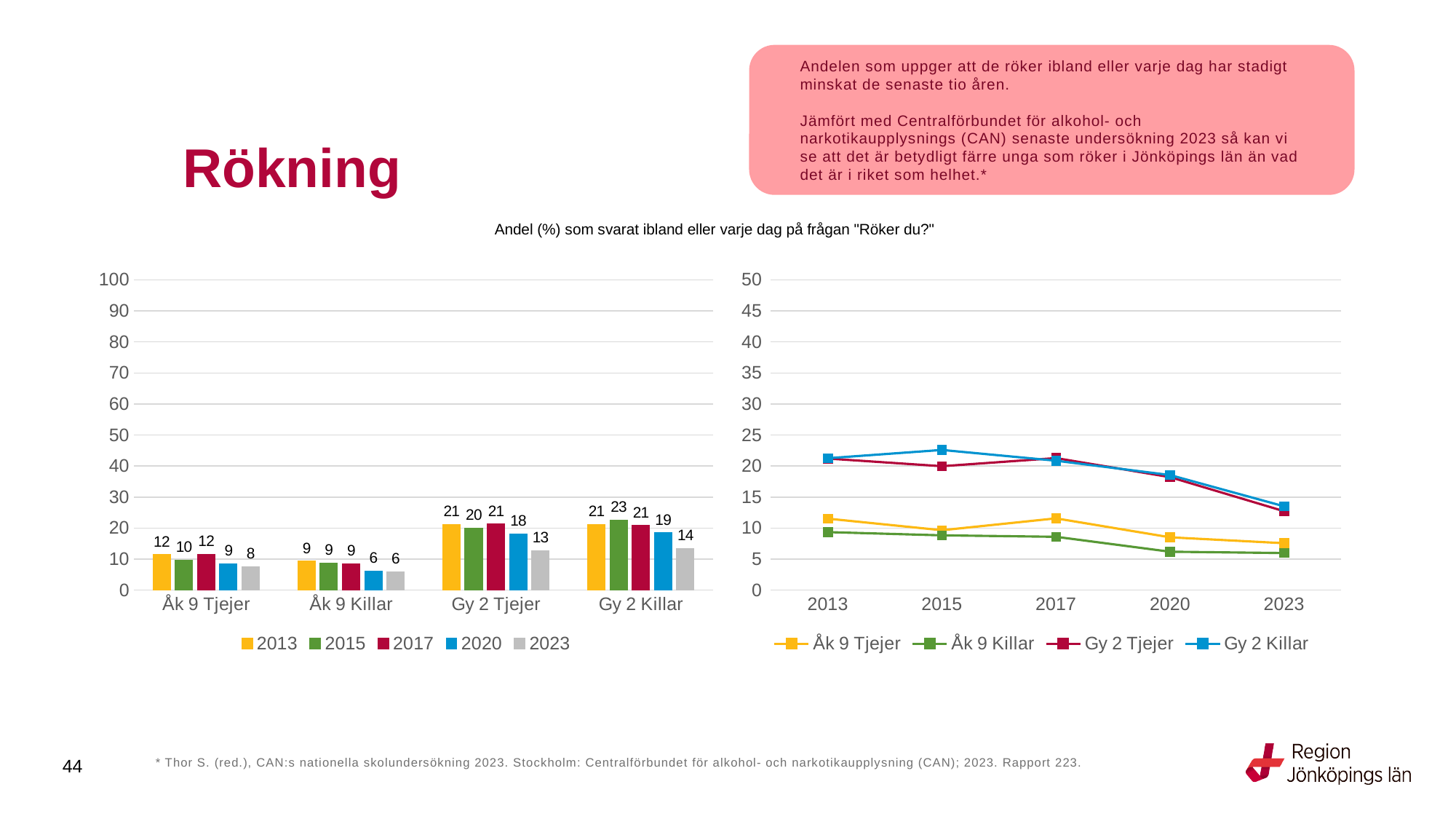
How many years are shown on the x axis of the line chart on the right? 5 In the bar chart on the left, which category has the lowest value for 2017? Åk 9 Killar What kind of chart is shown on the right side of the slide? Line chart In the bar chart on the left, what is the difference between the 2013 and 2023 values for Gy 2 Tjejer? 8 In the bar chart on the left, which category has the highest value for 2023? Gy 2 Killar In the bar chart on the left, what is the value for Gy 2 Killar in 2015? 23 In the line chart on the right, do the values for Gy 2 Tjejer rise or fall from 2017 to 2023? Fall In the bar chart on the left, what is the value for Åk 9 Tjejer in 2023? 8 In the bar chart on the left, what is the value for Åk 9 Killar in 2020? 6 How many series does the legend of the bar chart on the left list? 5 In the line chart on the right, is the value for Gy 2 Killar in 2015 greater or less than 20? greater In the bar chart on the left, which is larger: the 2020 value for Gy 2 Tjejer or the 2020 value for Gy 2 Killar? Gy 2 Killar